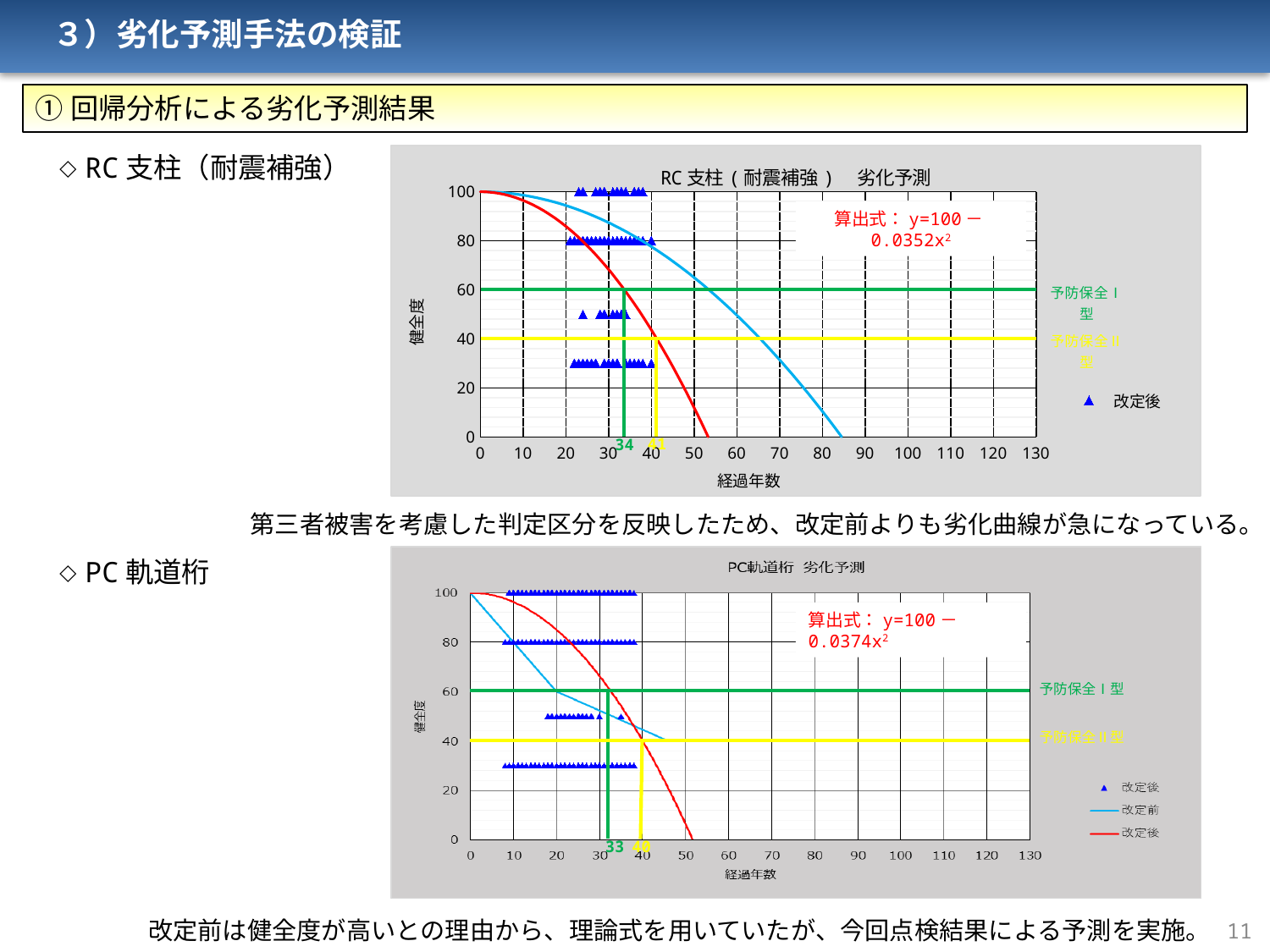
In the top chart titled 'RC 支柱（耐震補強） 劣化予測', what formula is shown for the deterioration curve? y=100－0.0352x² In the bottom chart 'PC軌道桁 劣化予測', at how many elapsed years does the red curve reach the 予防保全Ⅰ型 line (健全度 60), according to the label on the x axis? 33 In the top chart 'RC 支柱（耐震補強） 劣化予測', what is the highest value shown on the x axis (経過年数)? 130 In the bottom chart 'PC軌道桁 劣化予測', how many entries does the legend list? 3 In the top chart 'RC 支柱（耐震補強） 劣化予測', at how many elapsed years does the red curve reach the 予防保全Ⅱ型 line (健全度 40), according to the label on the x axis? 41 In the bottom chart 'PC軌道桁 劣化予測', at what 健全度 value is the yellow 予防保全Ⅱ型 horizontal line drawn? 40 In the bottom chart 'PC軌道桁 劣化予測', how many years apart are the labelled crossing points 33 and 40 on the x axis? 7 In the top chart 'RC 支柱（耐震補強） 劣化予測', at what 健全度 value is the green 予防保全Ⅰ型 horizontal line drawn? 60 In the bottom chart titled 'PC軌道桁 劣化予測', what formula is shown for the deterioration curve? y=100－0.0374x² In the bottom chart 'PC軌道桁 劣化予測', at how many elapsed years does the red curve reach the 予防保全Ⅱ型 line (健全度 40), according to the label on the x axis? 40 In the top chart 'RC 支柱（耐震補強） 劣化予測', how many years apart are the labelled crossing points 34 and 41 on the x axis? 7 In the top chart 'RC 支柱（耐震補強） 劣化予測', at how many elapsed years does the red curve reach the 予防保全Ⅰ型 line (健全度 60), according to the label on the x axis? 34